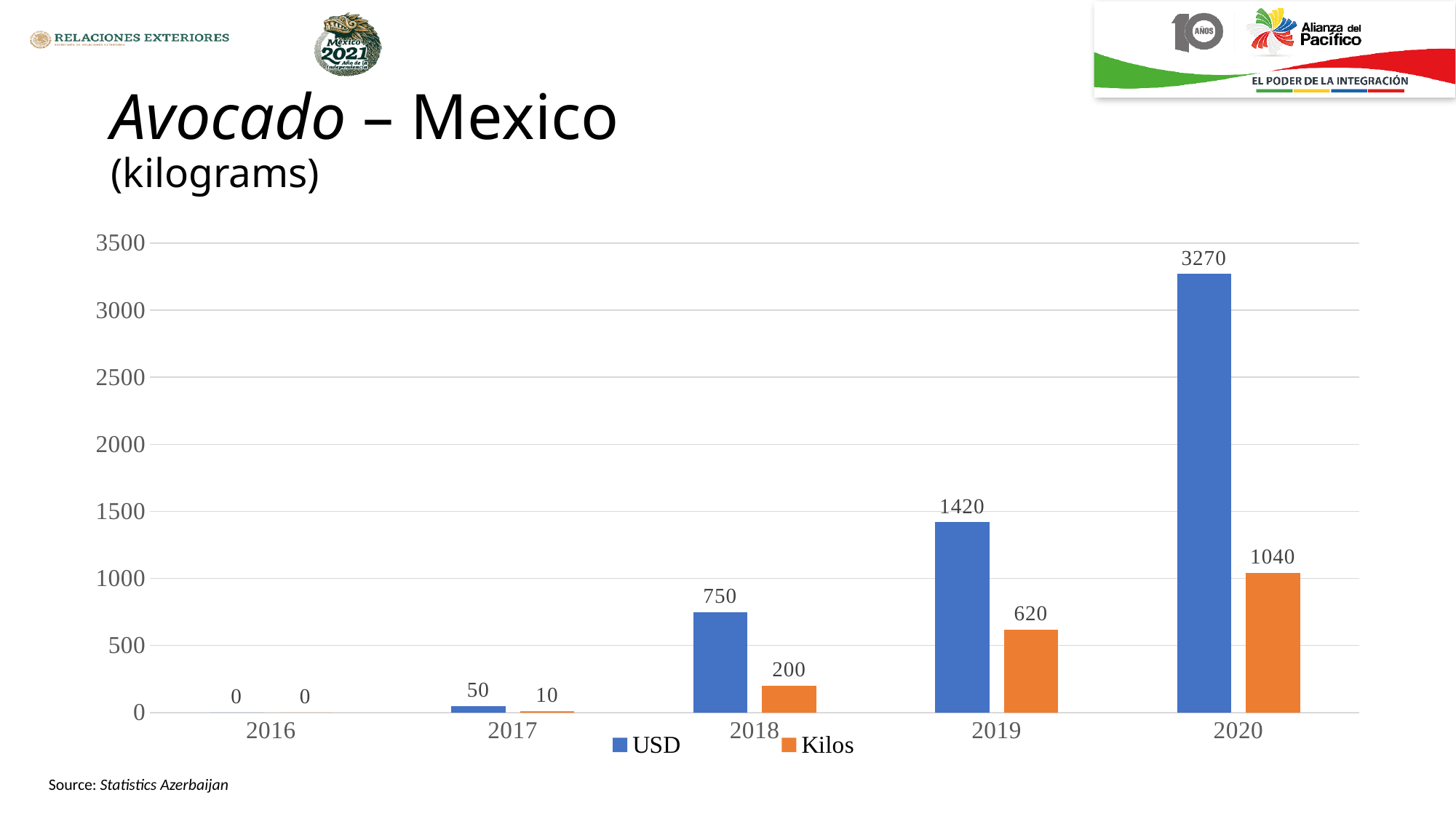
Which year has the lowest Kilos value? 2016 Do the USD values rise or fall from 2016 to 2020? Rise Which year has the highest USD value? 2020 What is the USD value for 2020? 3270 What is the difference between the USD value and the Kilos value in 2020? 2230 What is the USD value for 2018? 750 How many series does the legend list? 2 What kind of chart is shown on the slide? Bar chart How many years are shown on the x axis? 5 Which is larger, the USD value for 2019 or the Kilos value for 2020? USD value for 2019 What is the Kilos value for 2019? 620 What is the Kilos value for 2017? 10